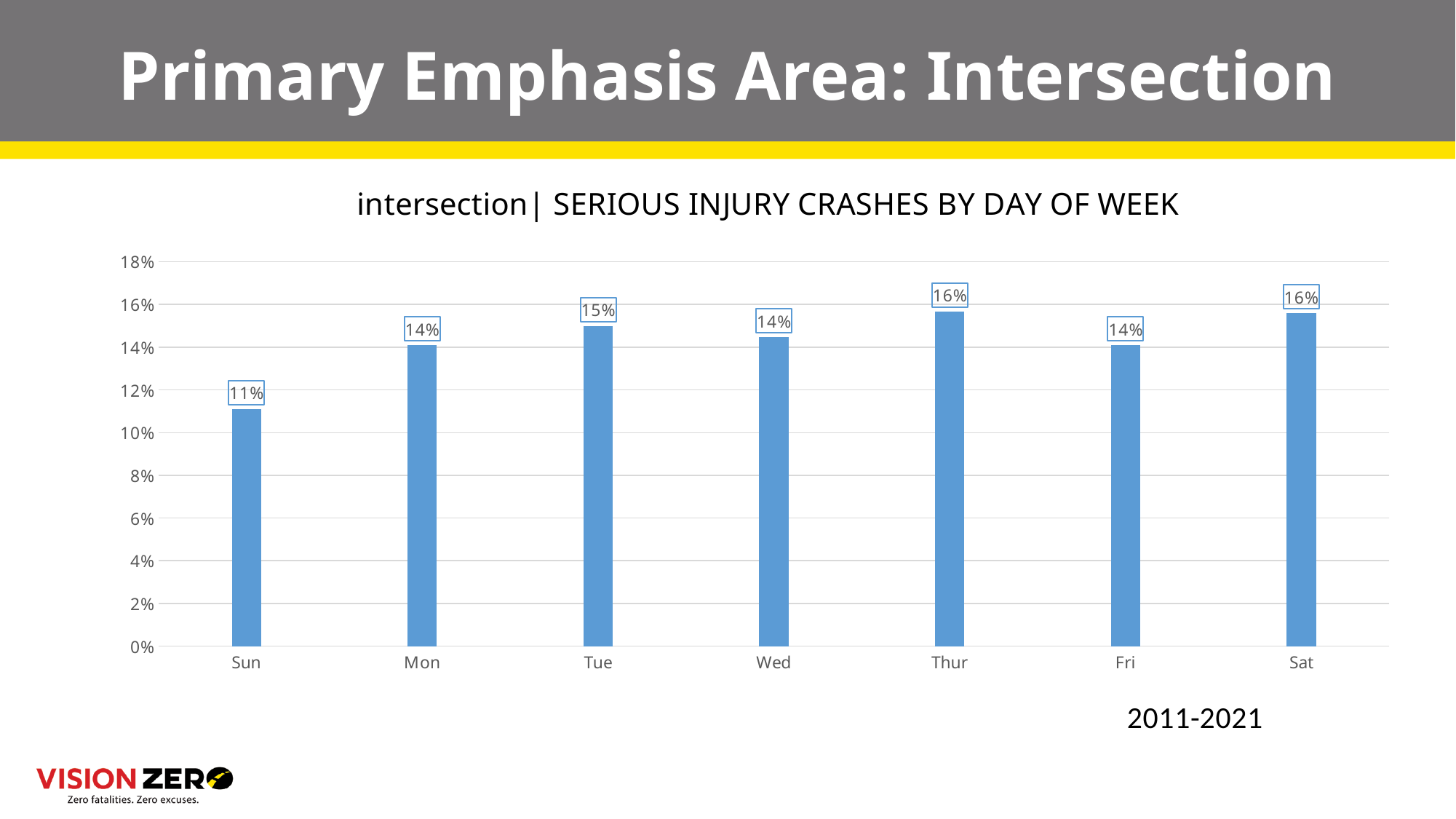
What is the value for Wed? 14% How many days of the week are shown on the x axis? 7 What time period is noted below the chart? 2011-2021 Which is larger, the value for Tue or the value for Sun? Tue Which day has the lowest share of serious injury crashes? Sun Is the value for Sun greater or less than 12%? less What is the title of the chart? intersection| SERIOUS INJURY CRASHES BY DAY OF WEEK What is the difference between the values for Tue and Sun? 4% What is the value for Tue? 15% What is the value for Thur? 16% What is the value for Sun? 11% What kind of chart is shown on the slide? bar chart